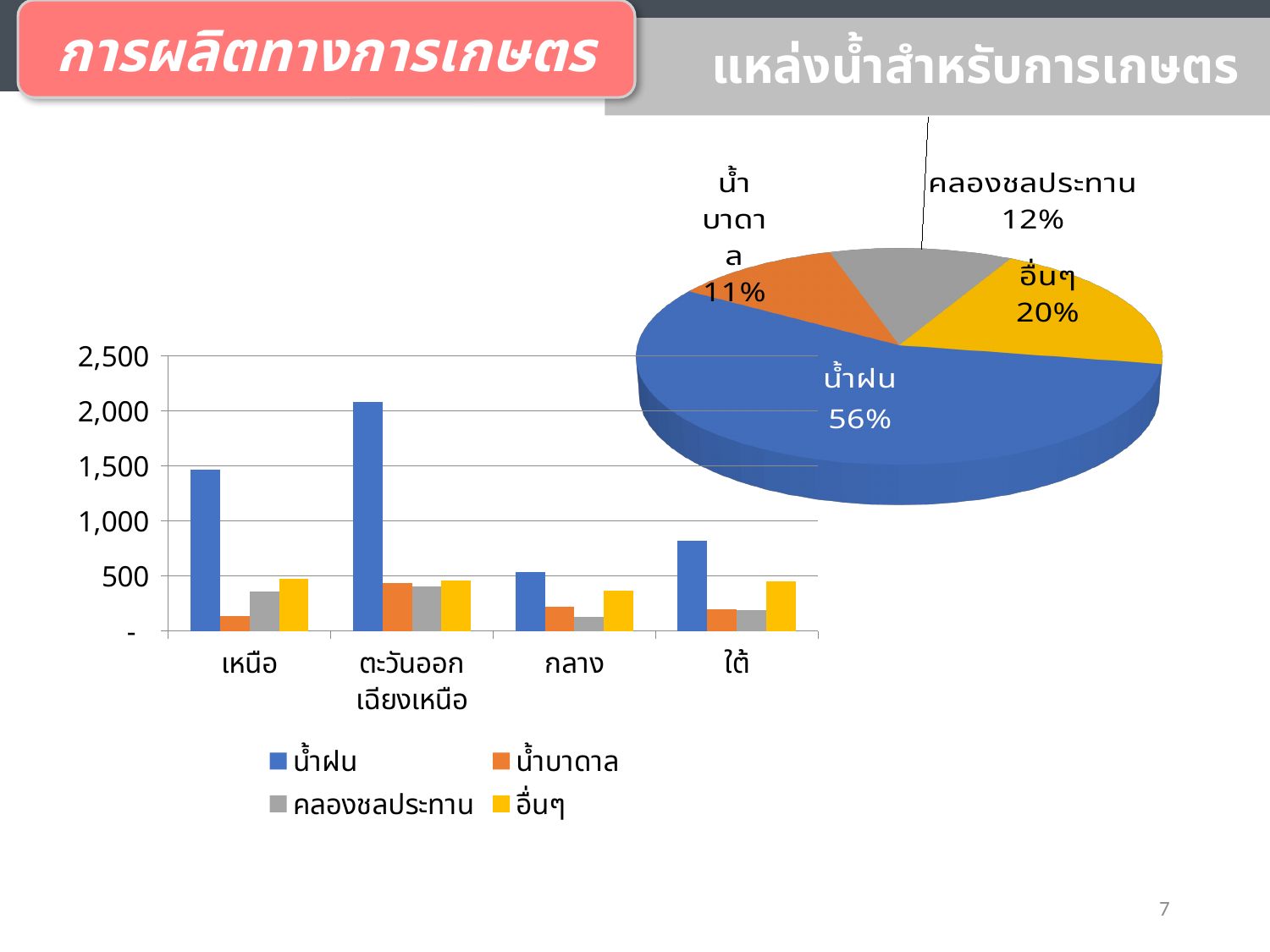
In the pie chart titled แหล่งน้ำสำหรับการเกษตร, what share does น้ำฝน have? 56% In the pie chart titled แหล่งน้ำสำหรับการเกษตร, which slice is the smallest? น้ำบาดาล In the bar chart on the left, which region has the highest น้ำฝน value? ตะวันออกเฉียงเหนือ In the pie chart titled แหล่งน้ำสำหรับการเกษตร, which slice is the largest? น้ำฝน In the bar chart on the left, is the น้ำฝน value for ใต้ greater or less than 1,000? less In the pie chart titled แหล่งน้ำสำหรับการเกษตร, what share does คลองชลประทาน have? 12% In the bar chart on the left, how many series does the legend list? 4 In the bar chart on the left, how many regions are shown on the x axis? 4 In the bar chart on the left, which is larger: the น้ำฝน value for เหนือ or for ใต้? เหนือ In the pie chart titled แหล่งน้ำสำหรับการเกษตร, how many percentage points larger is น้ำฝน than อื่นๆ? 36% In the bar chart on the left, is the น้ำฝน value for ตะวันออกเฉียงเหนือ greater or less than 2,000? greater In the pie chart titled แหล่งน้ำสำหรับการเกษตร, what share does อื่นๆ have? 20%